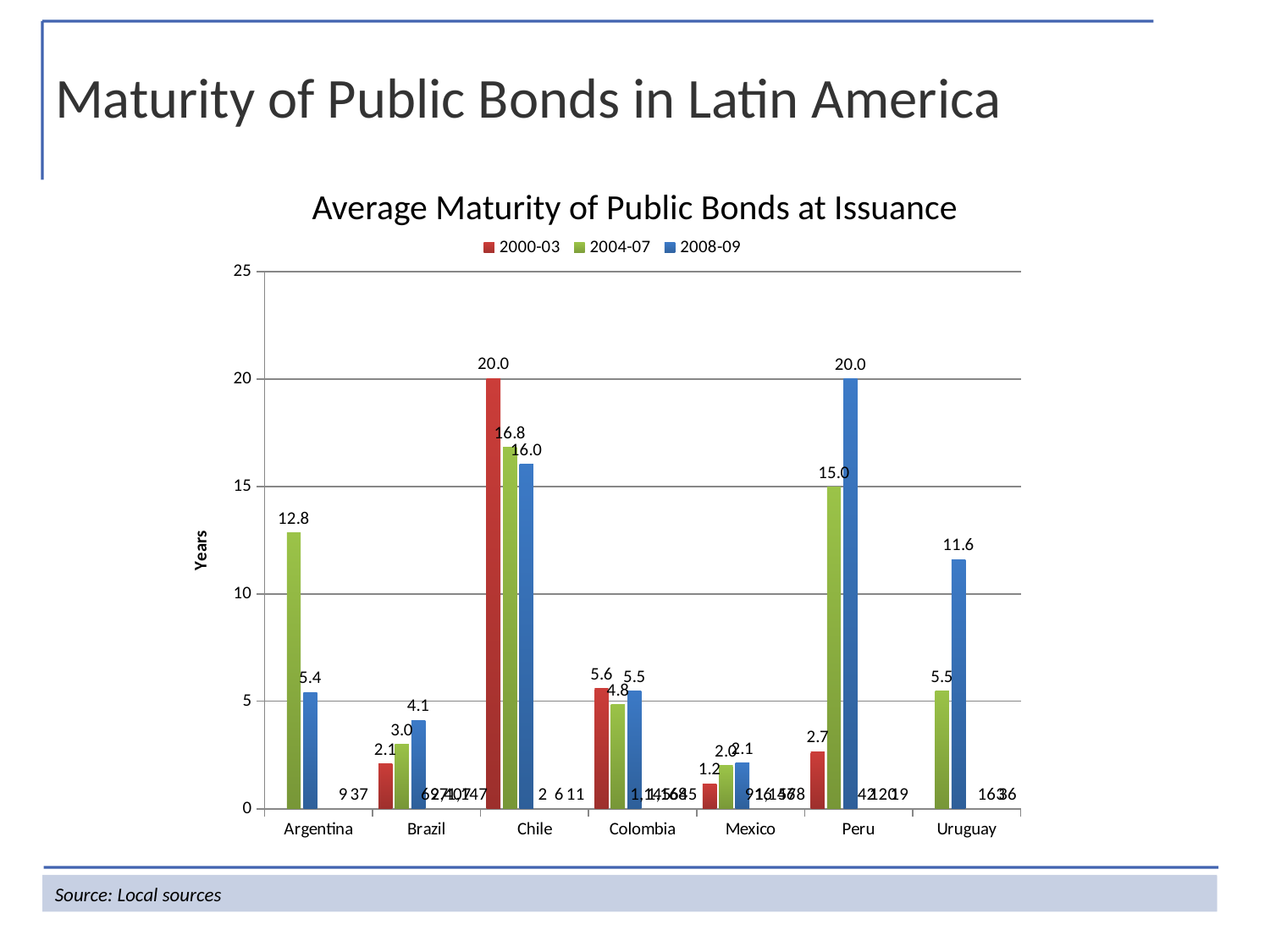
How many series does the legend list? 3 How many countries are shown on the x axis? 7 What is the difference between the 2008-09 values for Peru and Uruguay? 8.4 Which country has the highest value in the 2008-09 series? Peru Is the 2004-07 value for Chile greater or less than 15? greater Which country has the lowest value in the 2004-07 series? Mexico What is the average maturity for Chile in the 2000-03 series? 20.0 What is the value for Uruguay in the 2008-09 series? 11.6 What kind of chart is shown on the slide? Bar chart What is the value for Peru in the 2004-07 series? 15.0 What is the value for Argentina in the 2004-07 series? 12.8 Which is larger for Brazil: the 2004-07 value or the 2008-09 value? 2008-09